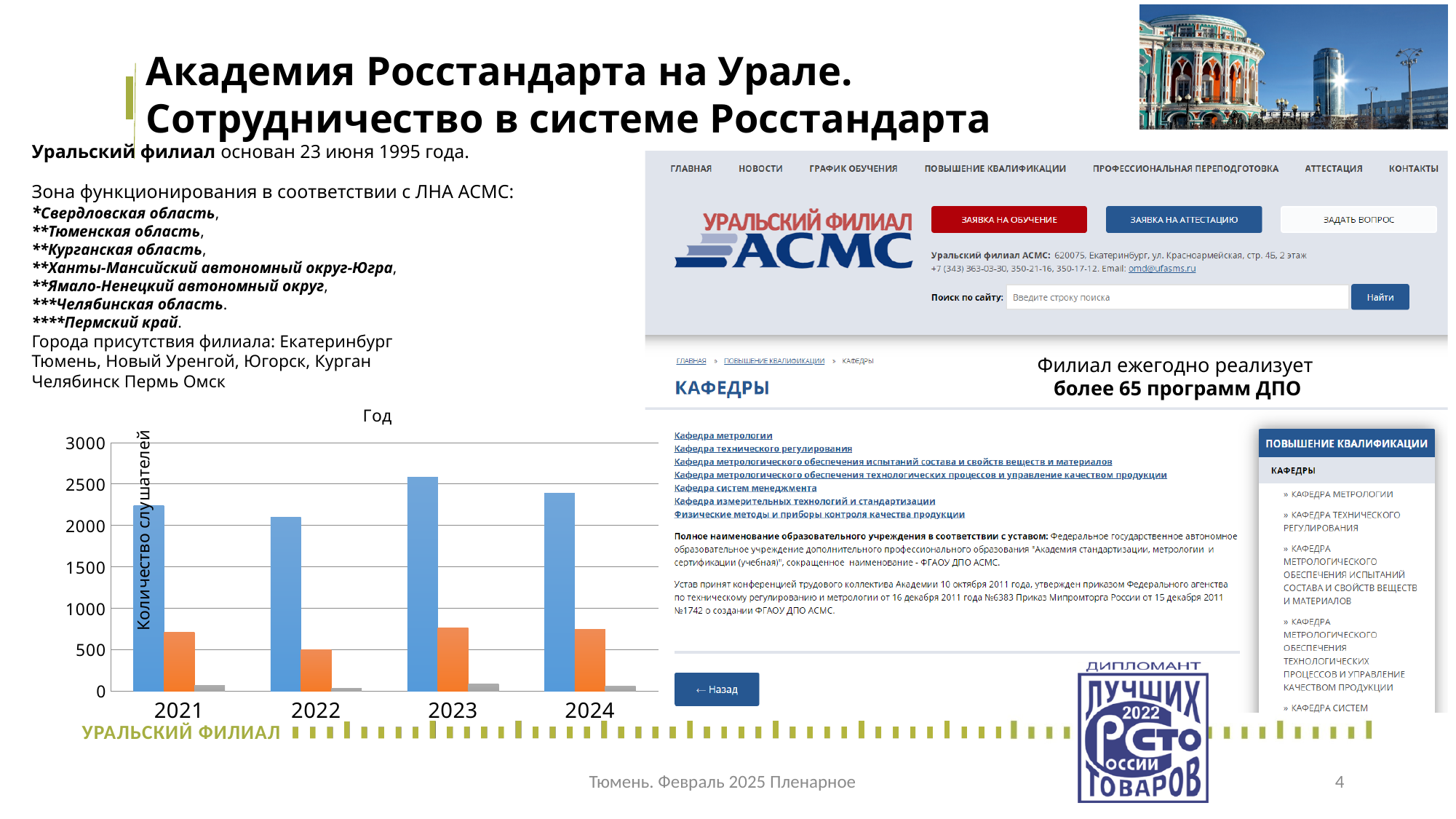
How many years are shown on the x axis of the chart? 4 Which year has the larger blue bar, 2023 or 2024? 2023 Is the value of the orange bar for 2021 greater or less than 500? greater What kind of chart is shown on the slide? bar chart Is the value of the blue bar for 2024 greater or less than 2500? less What title is printed above the chart? Год Is the value of the blue bar for 2023 greater or less than 2500? greater In which year is the blue bar the tallest? 2023 In which year is the orange bar the shortest? 2022 In which year is the blue bar the shortest? 2022 What is the label of the vertical axis of the chart? Количество слушателей